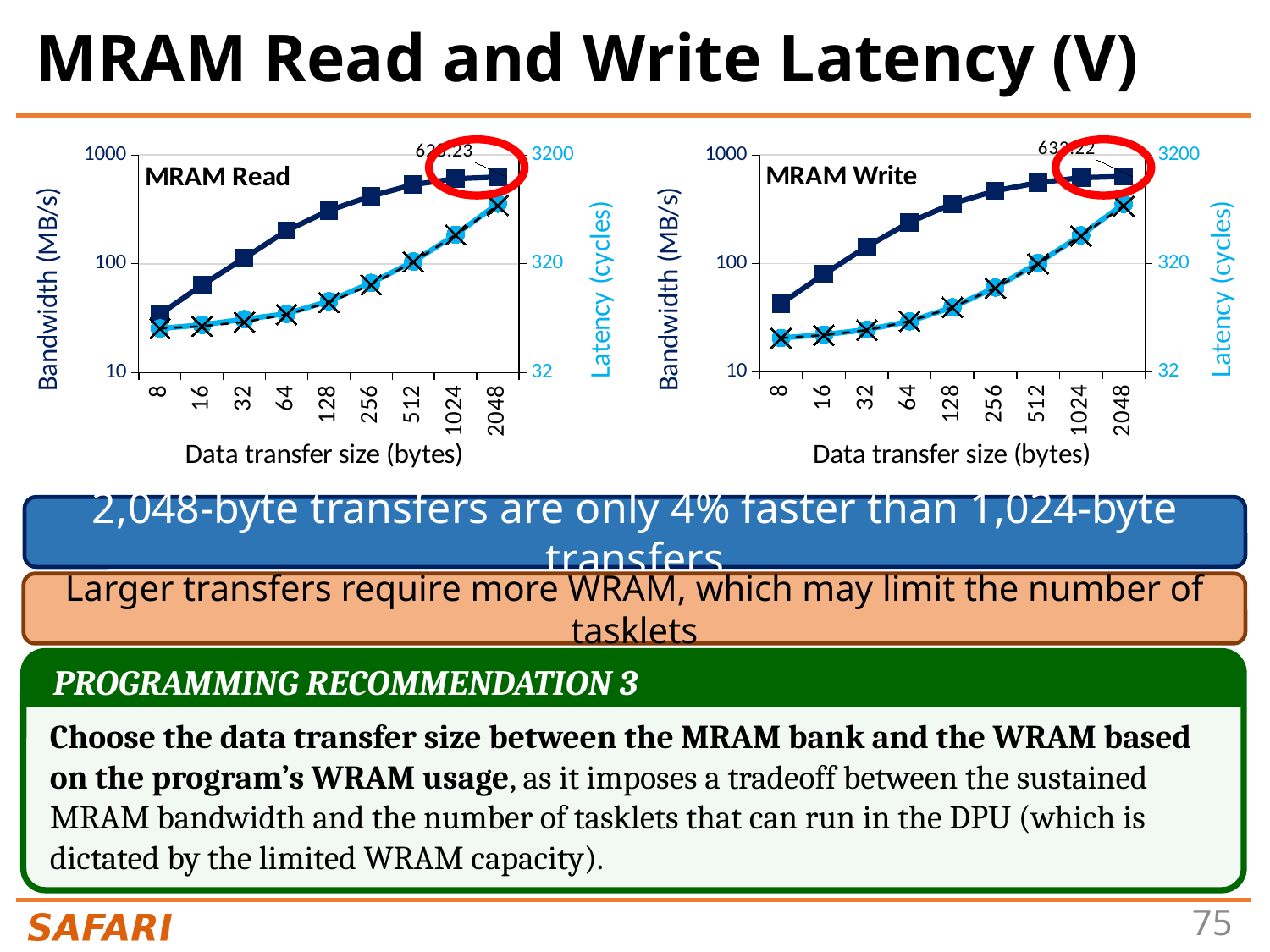
In the MRAM Read chart, which data transfer size has the lowest bandwidth? 8 What kind of chart is the MRAM Read chart? line chart In the MRAM Read chart, does bandwidth rise or fall as the data transfer size increases? rise What is the label of the x axis on the MRAM Read chart? Data transfer size (bytes) In the MRAM Read chart, is the bandwidth for a 2048-byte transfer greater or less than 100 MB/s? greater In the MRAM Read chart, is the bandwidth for an 8-byte transfer greater or less than 100 MB/s? less In the MRAM Write chart, which has the higher bandwidth: a 64-byte transfer or an 8-byte transfer? 64-byte transfer In the MRAM Write chart, does latency rise or fall as the data transfer size increases? rise What is the label of the right-hand y axis on the MRAM Write chart? Latency (cycles) In the MRAM Write chart, is the latency for an 8-byte transfer greater or less than 320 cycles? less How many data transfer sizes are plotted on the x axis of the MRAM Write chart? 9